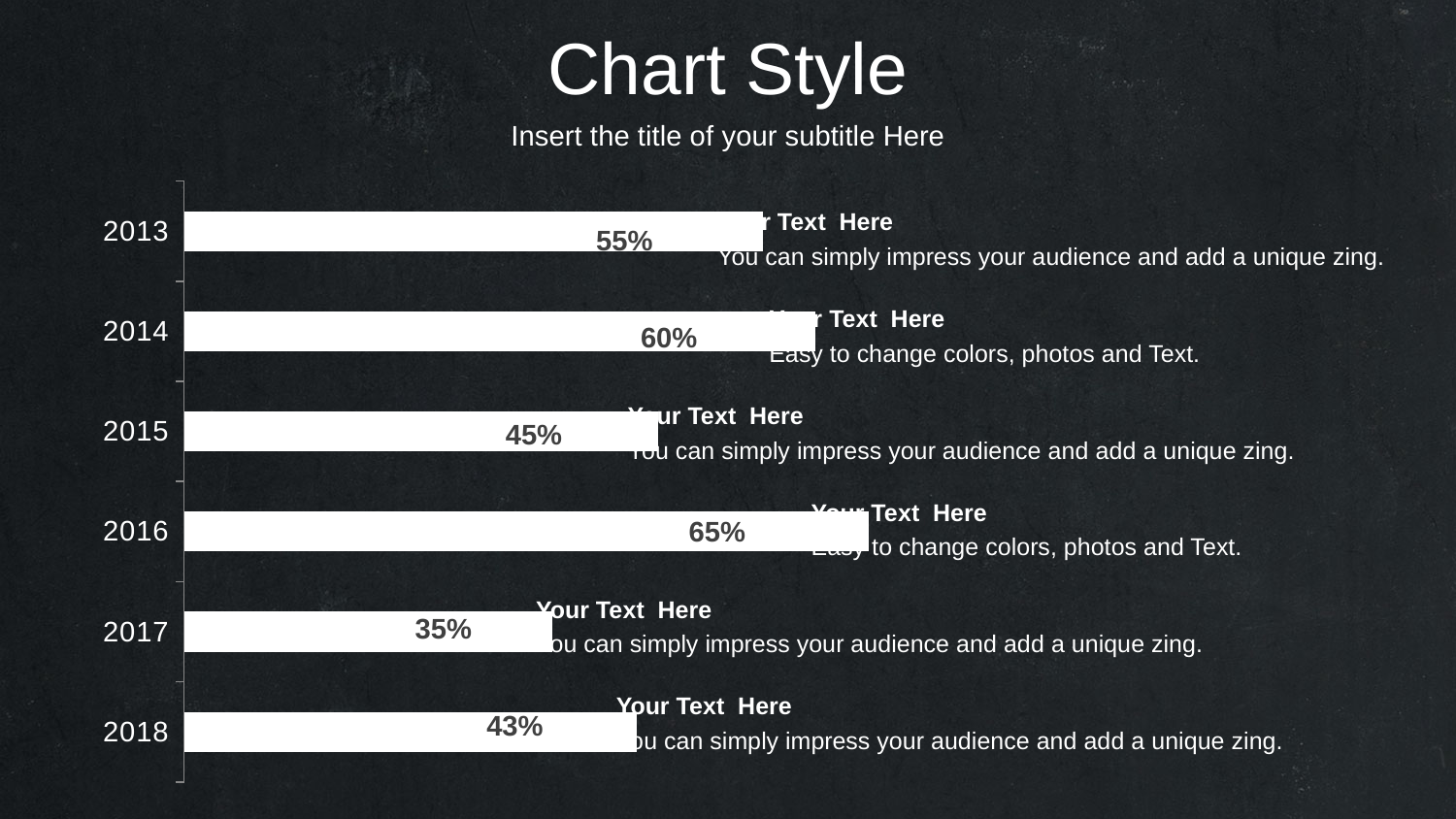
How many years are shown on the chart? 6 Which is larger, the value for 2015 or the value for 2014? 2014 Which is larger, the value for 2013 or the value for 2018? 2013 What kind of chart is shown on the slide? Bar chart What is the value for 2018? 43% What is the value for 2013? 55% What is the difference between the values for 2016 and 2017? 30% Which year has the highest value? 2016 What is the value for 2016? 65% Which year has the lowest value? 2017 What colour are the bars in the chart? White What is the difference between the values for 2014 and 2015? 15%